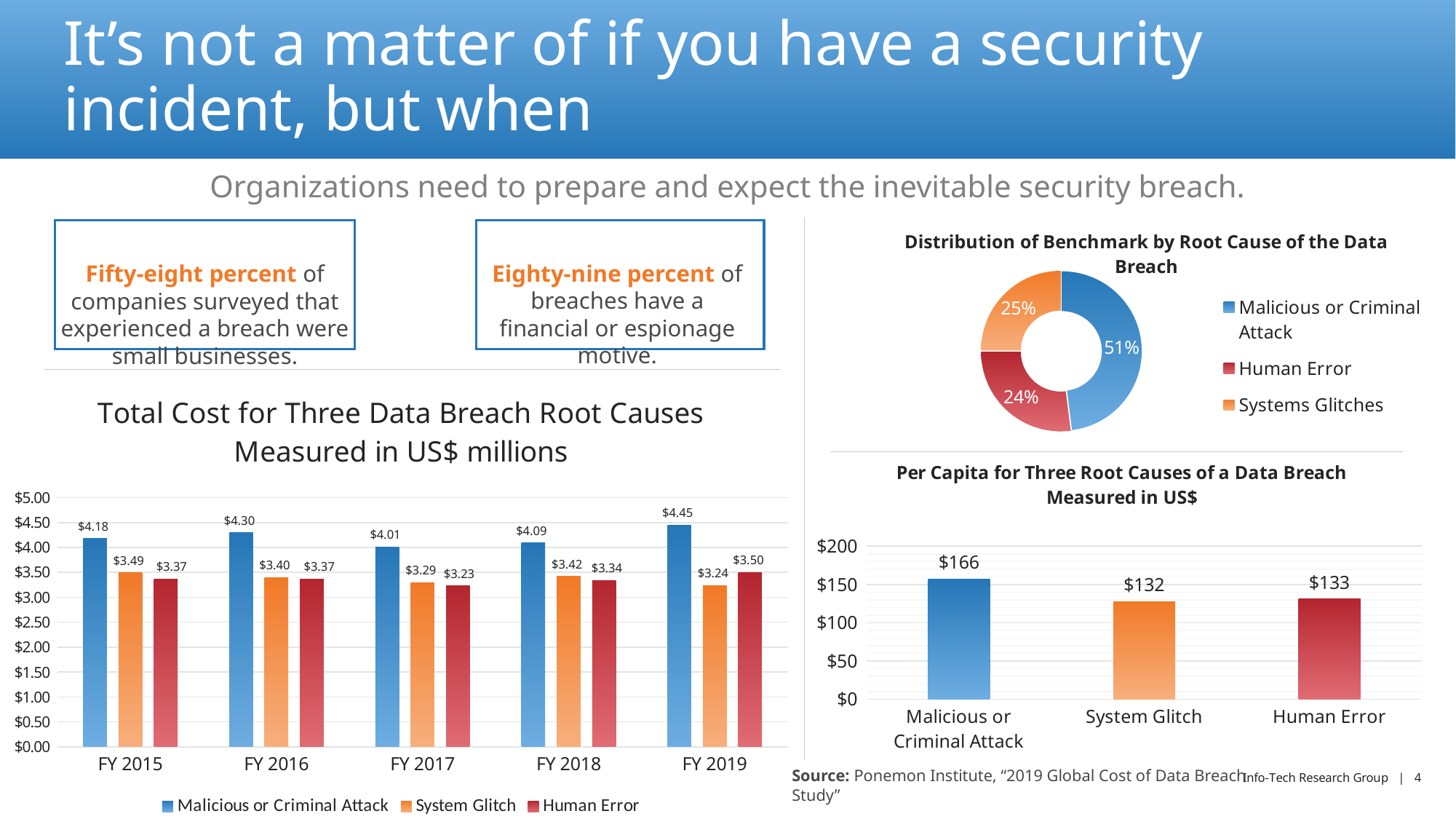
In the 'Per Capita for Three Root Causes of a Data Breach' chart, what is the difference between the Malicious or Criminal Attack value and the System Glitch value? $34 In the 'Total Cost for Three Data Breach Root Causes' chart, how many fiscal years are shown on the x axis? 5 In the 'Distribution of Benchmark by Root Cause of the Data Breach' chart, which root cause has the smallest share? Human Error In the 'Total Cost for Three Data Breach Root Causes' chart, what is the value for Malicious or Criminal Attack in FY 2019? $4.45 In the 'Total Cost for Three Data Breach Root Causes' chart, which fiscal year has the lowest value for Human Error? FY 2017 In the 'Distribution of Benchmark by Root Cause of the Data Breach' chart, what share does Malicious or Criminal Attack have? 51% In the 'Total Cost for Three Data Breach Root Causes' chart, which fiscal year has the highest value for Malicious or Criminal Attack? FY 2019 What kind of chart is the 'Per Capita for Three Root Causes of a Data Breach' chart? Bar chart In the 'Total Cost for Three Data Breach Root Causes' chart, what is the difference between the Malicious or Criminal Attack value and the Human Error value in FY 2015? $0.81 In the 'Total Cost for Three Data Breach Root Causes' chart, what is the value for System Glitch in FY 2017? $3.29 In the 'Total Cost for Three Data Breach Root Causes' chart, how many series does the legend list? 3 In the 'Per Capita for Three Root Causes of a Data Breach' chart, what is the value for Malicious or Criminal Attack? $166